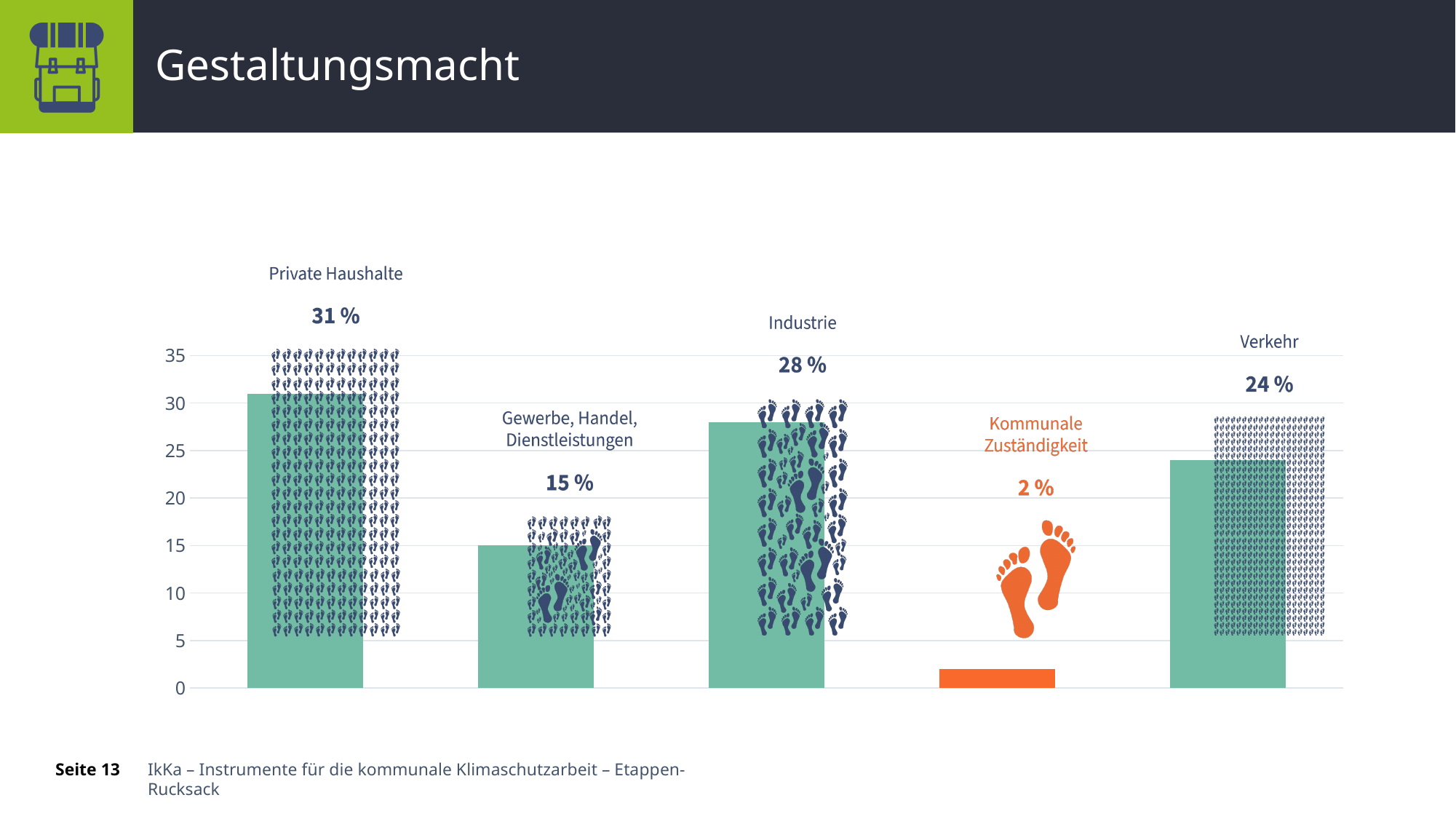
What is the difference between Private Haushalte and Industrie? 3 % What is the value for Kommunale Zuständigkeit? 2 % Which category has the highest value? Private Haushalte What is the value for Verkehr? 24 % Which is larger, Industrie or Verkehr? Industrie How many categories are shown in the chart? 5 Which category has the lowest value? Kommunale Zuständigkeit What is the difference between Verkehr and Gewerbe, Handel, Dienstleistungen? 9 % Which category's bar is coloured orange instead of green? Kommunale Zuständigkeit What kind of chart is shown on the slide? bar chart What is the value for Private Haushalte? 31 % What is the value for Industrie? 28 %